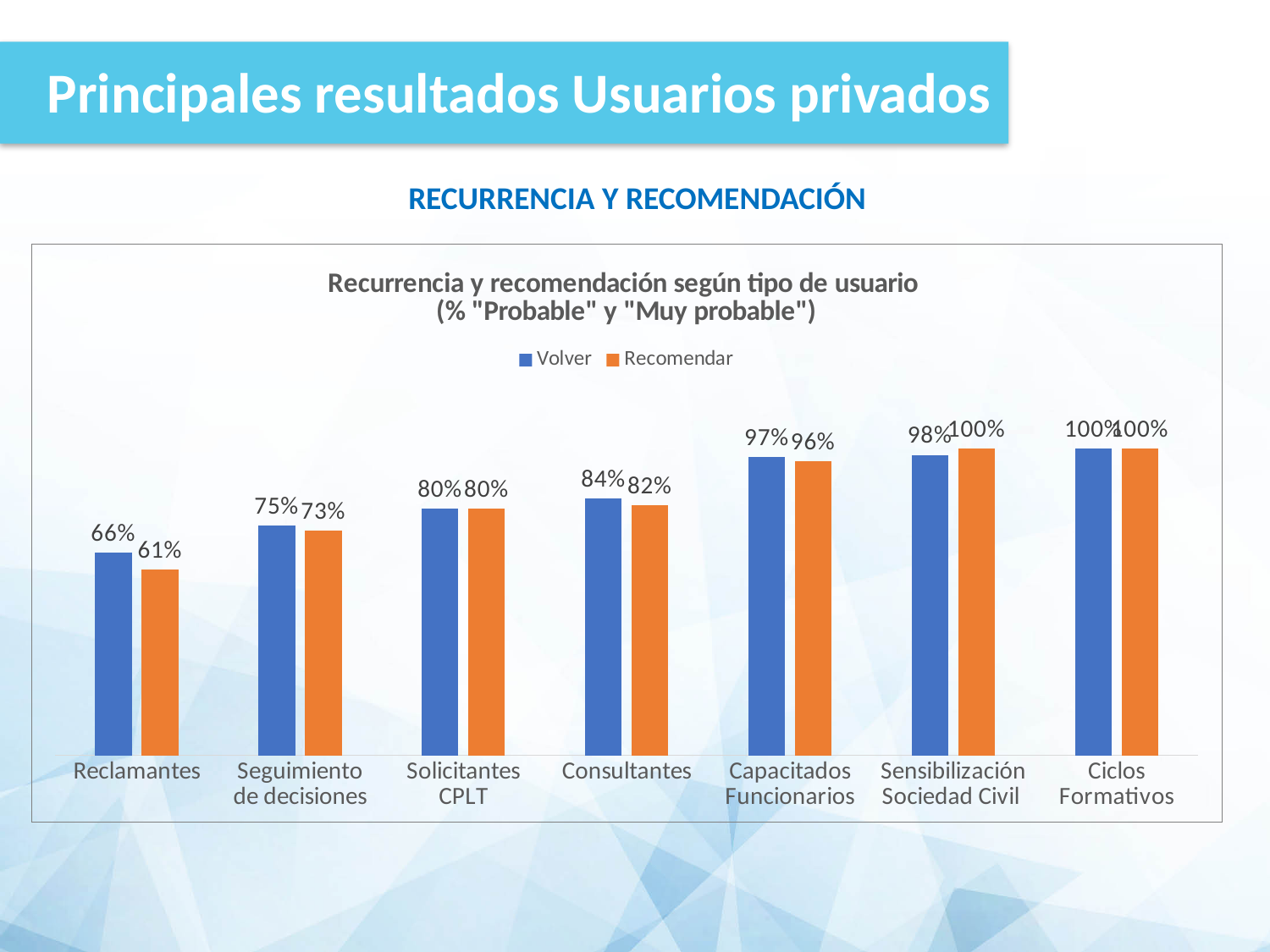
Do the Volver values rise or fall from Reclamantes to Ciclos Formativos? Rise Which is larger for Capacitados Funcionarios: Volver or Recomendar? Volver Which colour represents the Recomendar series? Orange What is the Volver value for Reclamantes? 66% How many series does the legend list? 2 How many categories are shown on the x axis? 7 Which category has the highest Volver value? Ciclos Formativos What is the Recomendar value for Seguimiento de decisiones? 73% Which category has the lowest Volver value? Reclamantes What kind of chart is shown? Bar chart What is the difference between the Volver and Recomendar values for Reclamantes? 5% What is the Recomendar value for Consultantes? 82%